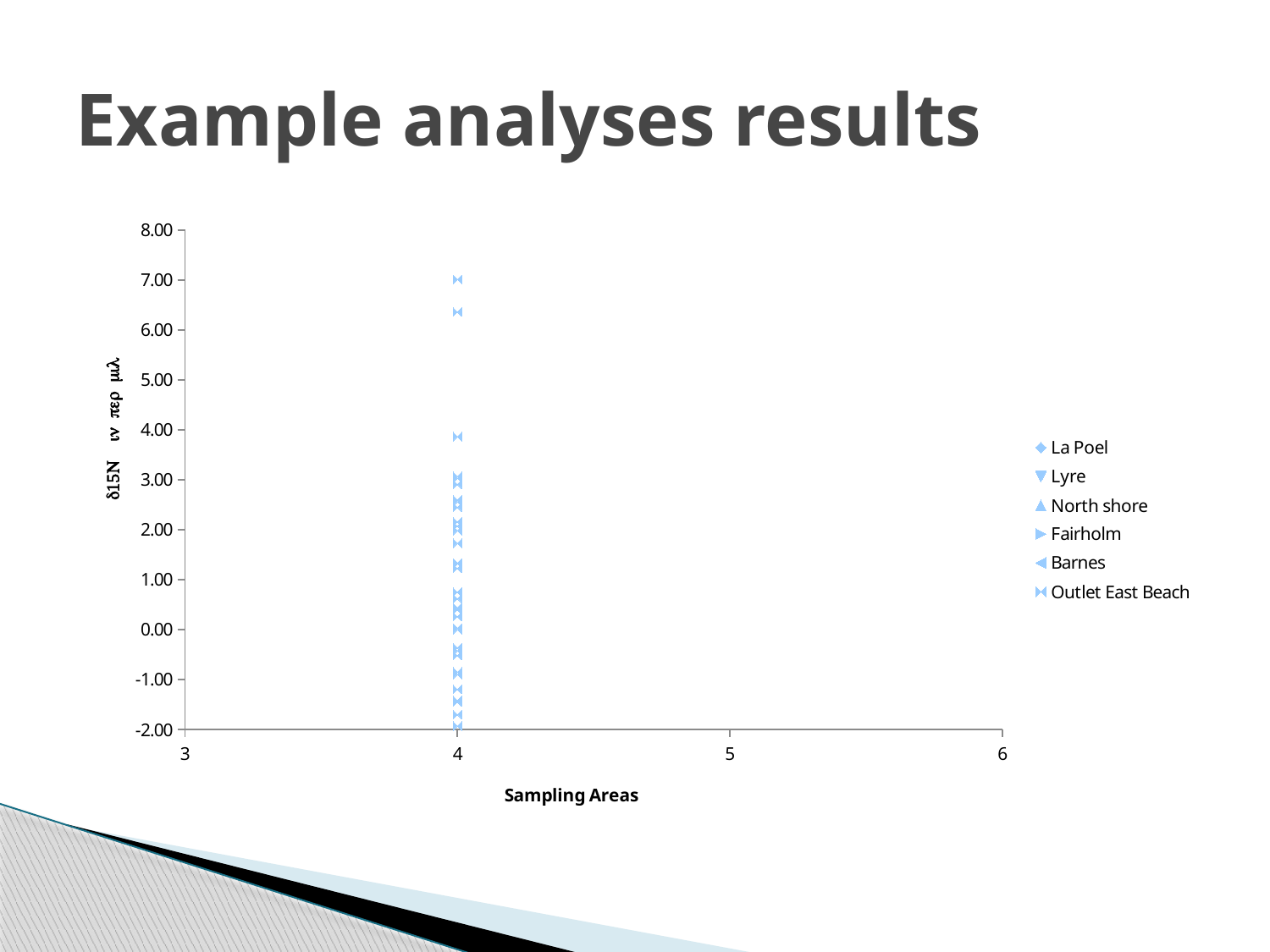
Is the second-highest plotted point greater or less than 5.00? greater Is the lowest plotted value greater or less than 0.00? less Is the highest plotted value greater or less than 6.00? greater At which x-axis value are all the plotted points located? 4 Which legend series uses the bowtie marker that appears in the plotted points? Outlet East Beach How many series does the legend list? 6 What kind of chart is shown on the slide? scatter chart What is the title of the x axis? Sampling Areas